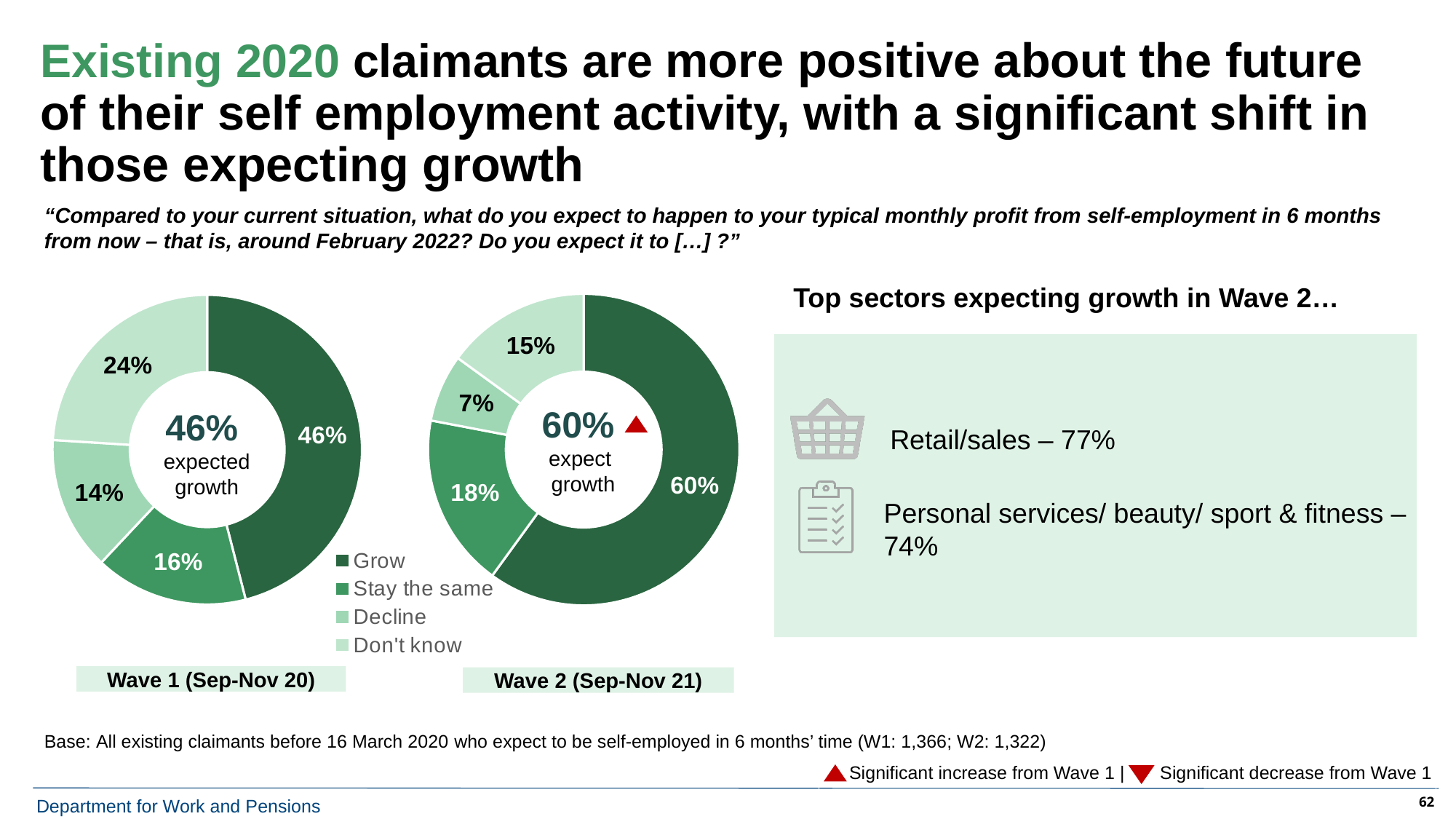
What does the red triangle next to the 60% in the Wave 2 chart indicate? Significant increase from Wave 1 In the Wave 2 (Sep-Nov 21) chart, what percentage expect their profit to stay the same? 18% What type of chart is used to show the Wave 1 and Wave 2 results? Donut (pie) chart In the Wave 1 (Sep-Nov 20) chart, which category has the smallest share? Decline Is the 'Decline' share larger in the Wave 1 (Sep-Nov 20) chart or the Wave 2 (Sep-Nov 21) chart? Wave 1 (Sep-Nov 20) In the Wave 1 (Sep-Nov 20) chart, what percentage answered 'Don't know'? 24% How many categories does the legend list for the donut charts? 4 In the Wave 2 (Sep-Nov 21) chart, what is the combined share of 'Decline' and 'Don't know'? 22% What is the difference in the 'Grow' share between the Wave 2 (Sep-Nov 21) chart and the Wave 1 (Sep-Nov 20) chart? 14 percentage points In the Wave 2 (Sep-Nov 21) chart, what percentage of claimants expect their profit to decline? 7% In the Wave 1 (Sep-Nov 20) chart, what percentage of claimants expect their profit to grow? 46% In the Wave 2 (Sep-Nov 21) chart, which category has the largest share? Grow